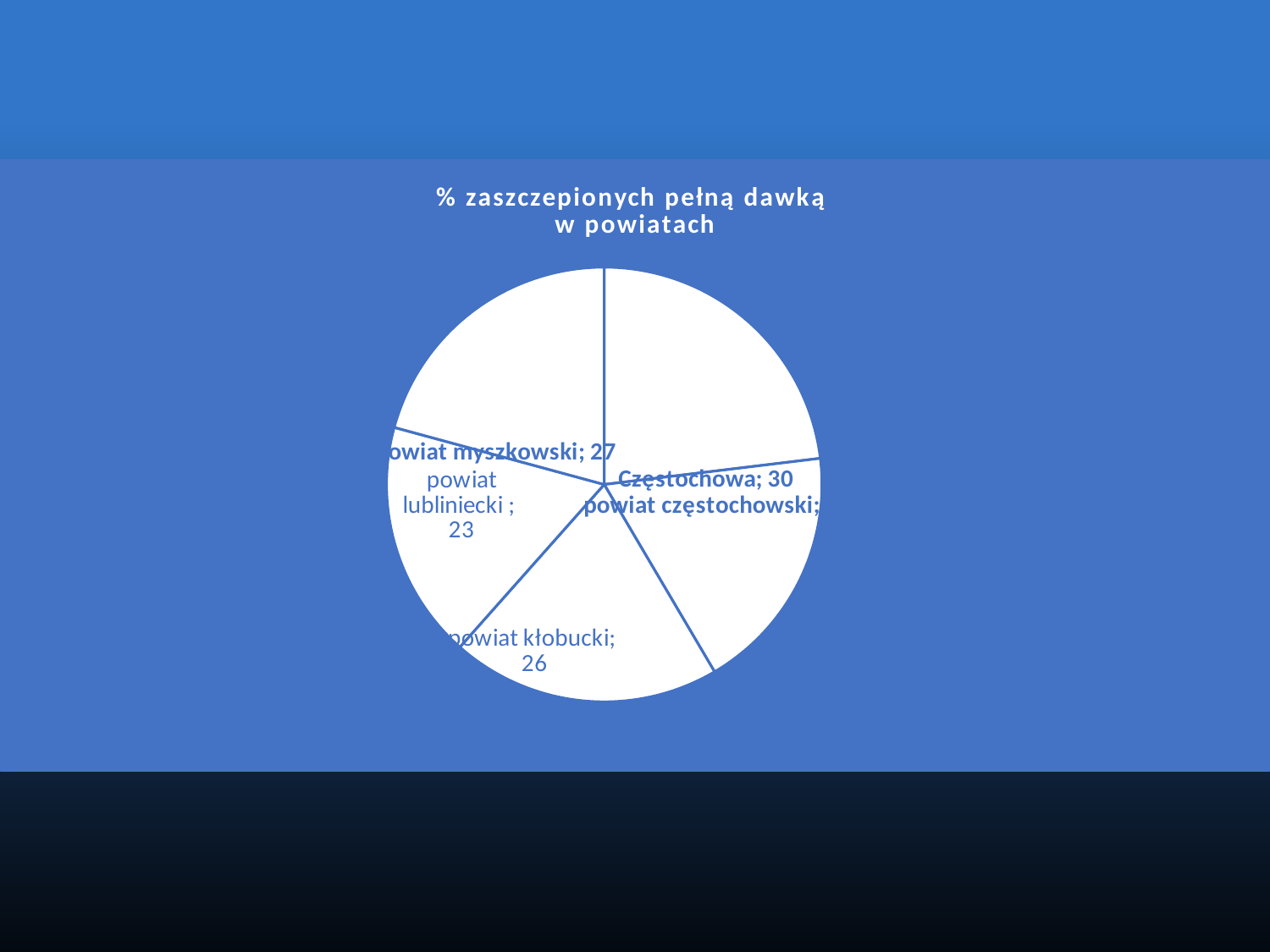
Which is larger, the value for powiat lubliniecki or the value for powiat myszkowski? powiat myszkowski What is the value for powiat myszkowski? 27 What is the value for powiat lubliniecki? 23 What is the title of the chart? % zaszczepionych pełną dawką w powiatach What is the difference between the values for powiat myszkowski and powiat kłobucki? 1 Which category has the largest slice of the pie? Częstochowa What is the difference between the values for Częstochowa and powiat lubliniecki? 7 How many slices does the pie chart have? 5 What is the value for powiat kłobucki? 26 What kind of chart is shown on the slide? pie chart What is the value for Częstochowa? 30 Which is larger, the value for Częstochowa or the value for powiat kłobucki? Częstochowa